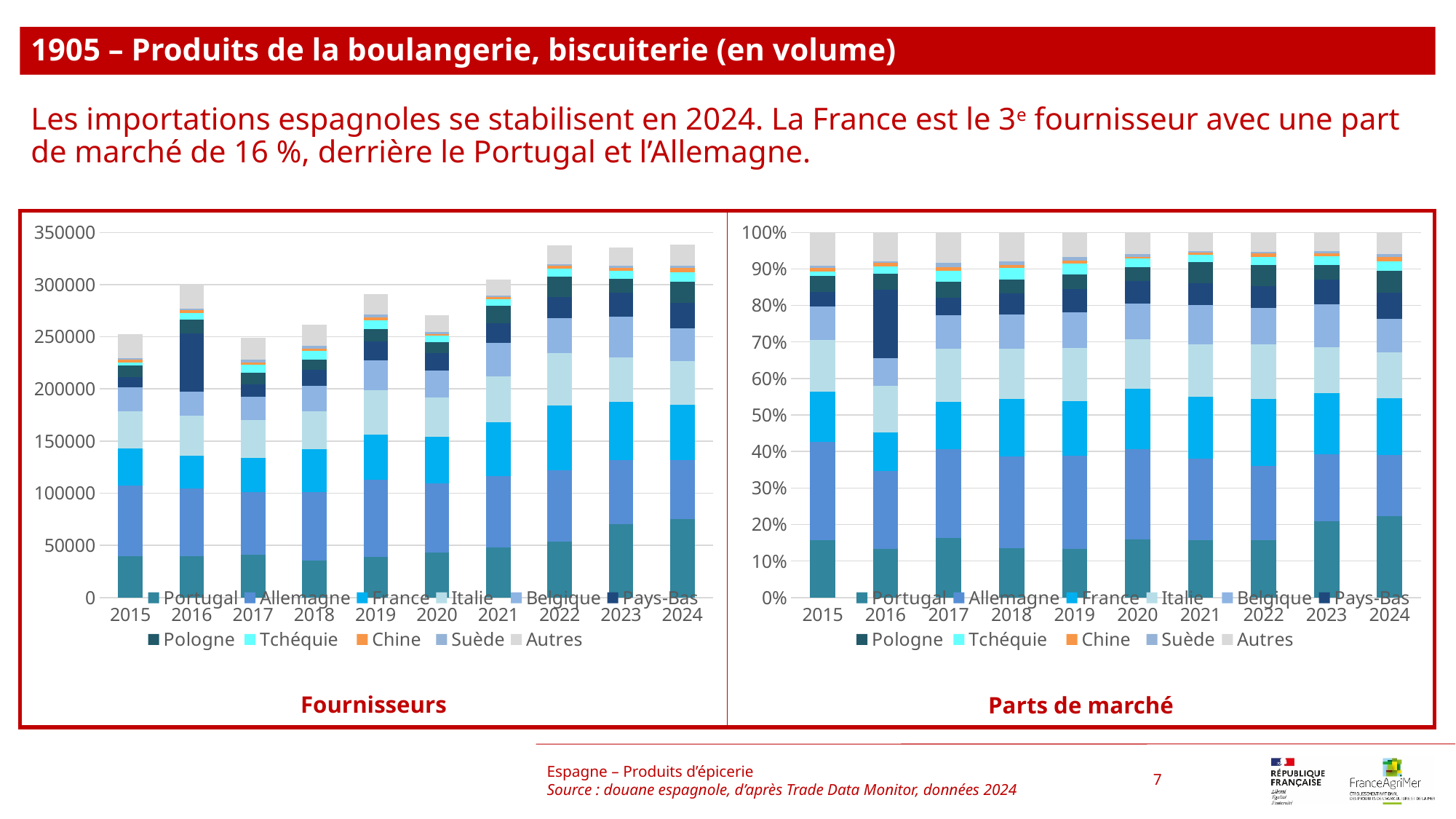
In the 'Fournisseurs' chart, is the Portugal segment for 2024 greater or less than 50000? greater What kind of chart is the 'Fournisseurs' chart on the left? stacked bar chart Which series is listed last in the legend of the 'Parts de marché' chart? Autres In the 'Fournisseurs' chart, is the total stacked bar for 2024 greater or less than 300000? greater How many series does the legend of the 'Fournisseurs' chart list? 11 In the 'Fournisseurs' chart, do the total bars rise or fall from 2020 to 2022? rise In the 'Fournisseurs' chart, is the total stacked bar for 2015 greater or less than 300000? less In the 'Parts de marché' chart, which year has the larger Portugal share, 2015 or 2024? 2024 How many years are shown on the x axis of the 'Parts de marché' chart? 10 In the 'Fournisseurs' chart, which year has the larger total bar, 2016 or 2017? 2016 What is the title printed under the right-hand chart? Parts de marché